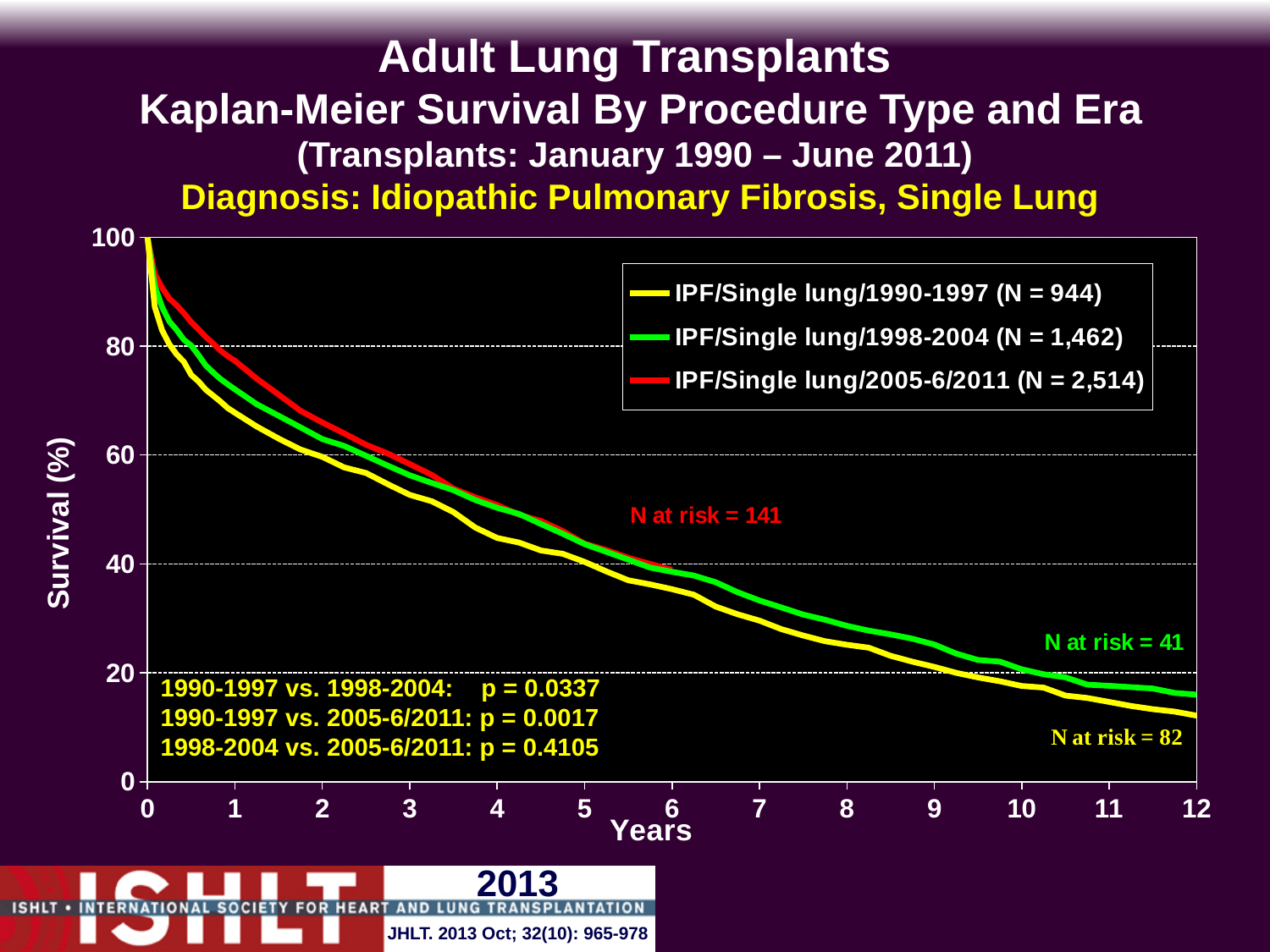
What is the N for the IPF/Single lung/1990-1997 series in the legend? 944 What kind of chart is shown on the slide? line chart What is the N for the IPF/Single lung/1998-2004 series in the legend? 1,462 How many series does the legend list? 3 What is the N at risk shown in red for the 2005-6/2011 series? 141 Do the survival curves rise or fall as years increase? fall At year 2, which series has higher survival: IPF/Single lung/2005-6/2011 or IPF/Single lung/1990-1997? IPF/Single lung/2005-6/2011 What is the N for the IPF/Single lung/2005-6/2011 series in the legend? 2,514 Is the survival value for IPF/Single lung/1998-2004 at year 12 greater or less than 20? less What is the p-value for 1990-1997 vs. 2005-6/2011? p = 0.0017 Is the survival value for IPF/Single lung/1990-1997 at year 4 greater or less than 60? less Which series has the lowest survival curve across the years? IPF/Single lung/1990-1997